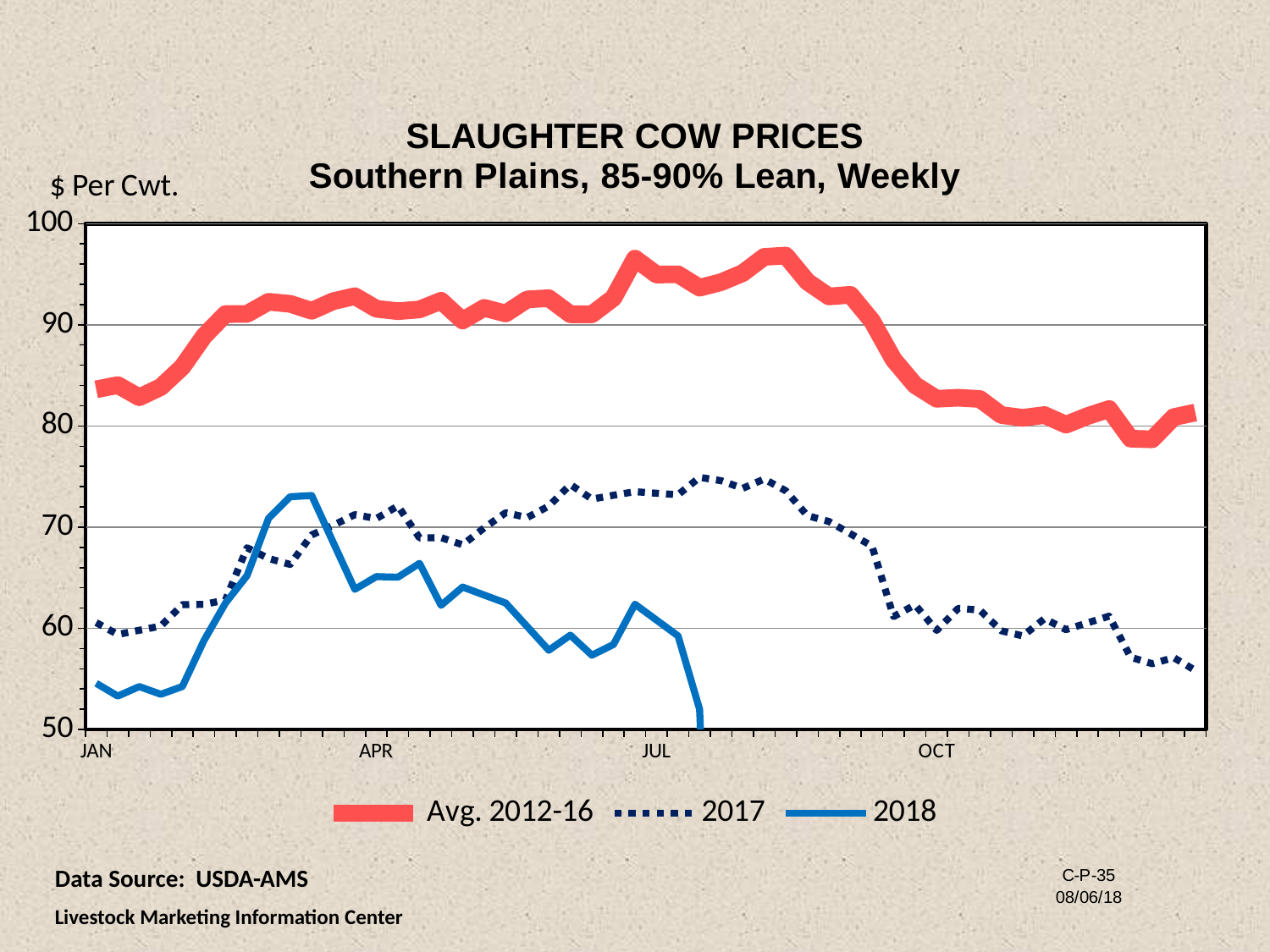
What is the title of the chart? SLAUGHTER COW PRICES Southern Plains, 85-90% Lean, Weekly What unit label is shown on the vertical axis? $ Per Cwt. Is the value for 2017 at JUL greater or less than 70? greater Is the value for 2018 at JAN greater or less than 60? less Which series has the highest values across the year? Avg. 2012-16 At JAN, which is higher, the 2017 line or the 2018 line? 2017 Is the value for 2018 at APR greater or less than 60? greater What kind of chart is shown on the slide? line chart Does the Avg. 2012-16 line rise or fall from OCT to the end of the year? fall How many series does the legend list? 3